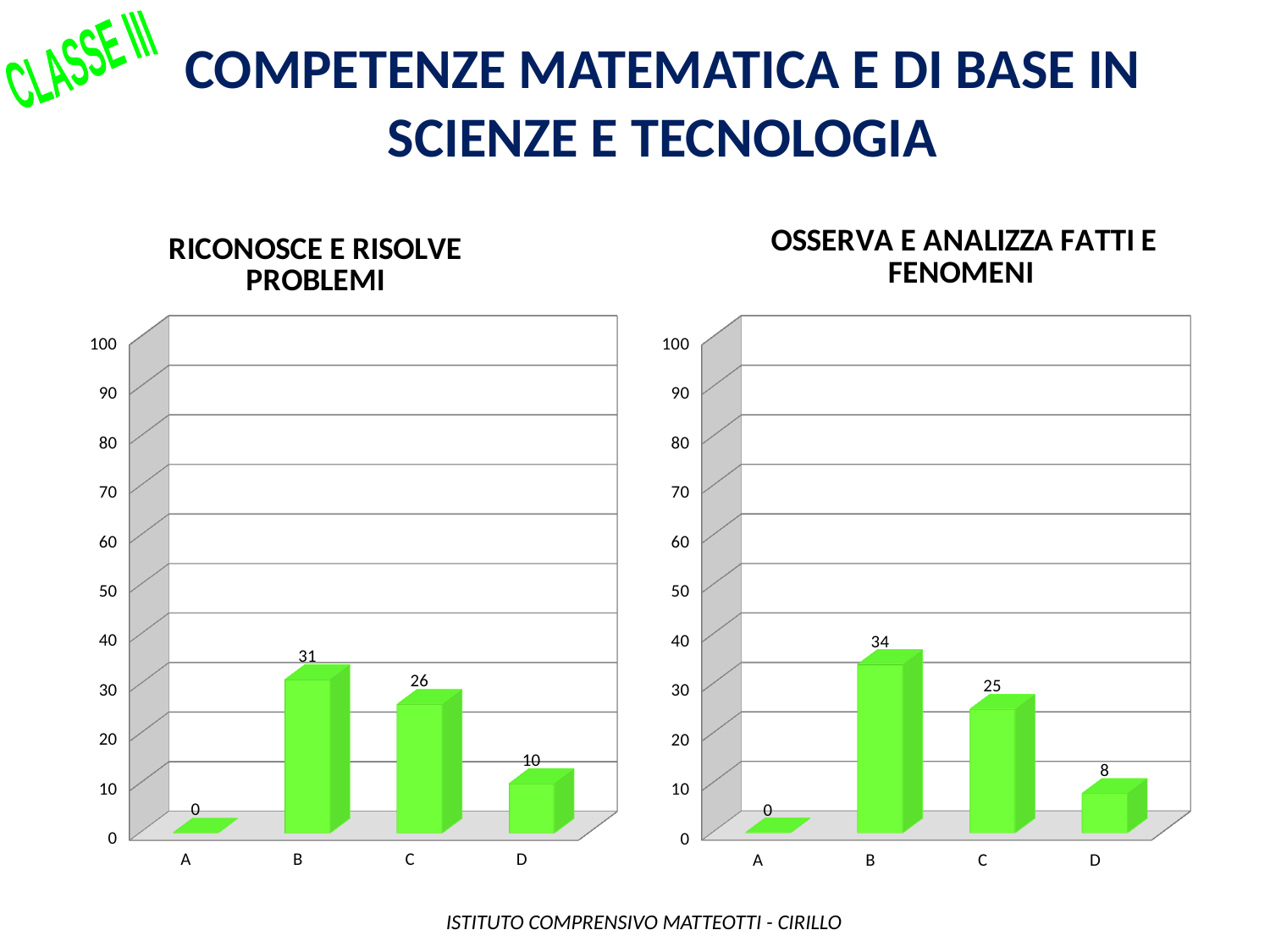
In the 'RICONOSCE E RISOLVE PROBLEMI' chart, what is the value for category B? 31 In the 'RICONOSCE E RISOLVE PROBLEMI' chart, what is the difference between the values for B and C? 5 What kind of chart is the 'OSSERVA E ANALIZZA FATTI E FENOMENI' chart? Bar chart In the 'OSSERVA E ANALIZZA FATTI E FENOMENI' chart, is the value for B greater or less than 30? greater In the 'OSSERVA E ANALIZZA FATTI E FENOMENI' chart, which category has the lowest value? A How many categories are shown on the x axis of the 'RICONOSCE E RISOLVE PROBLEMI' chart? 4 In the 'OSSERVA E ANALIZZA FATTI E FENOMENI' chart, what is the value for category C? 25 In the 'RICONOSCE E RISOLVE PROBLEMI' chart, what is the value for category A? 0 In the 'RICONOSCE E RISOLVE PROBLEMI' chart, which category has the highest value? B Which is larger: the value for D in the 'RICONOSCE E RISOLVE PROBLEMI' chart or the value for D in the 'OSSERVA E ANALIZZA FATTI E FENOMENI' chart? RICONOSCE E RISOLVE PROBLEMI What is the title of the chart on the left of the slide? RICONOSCE E RISOLVE PROBLEMI In the 'OSSERVA E ANALIZZA FATTI E FENOMENI' chart, what is the difference between the values for B and D? 26